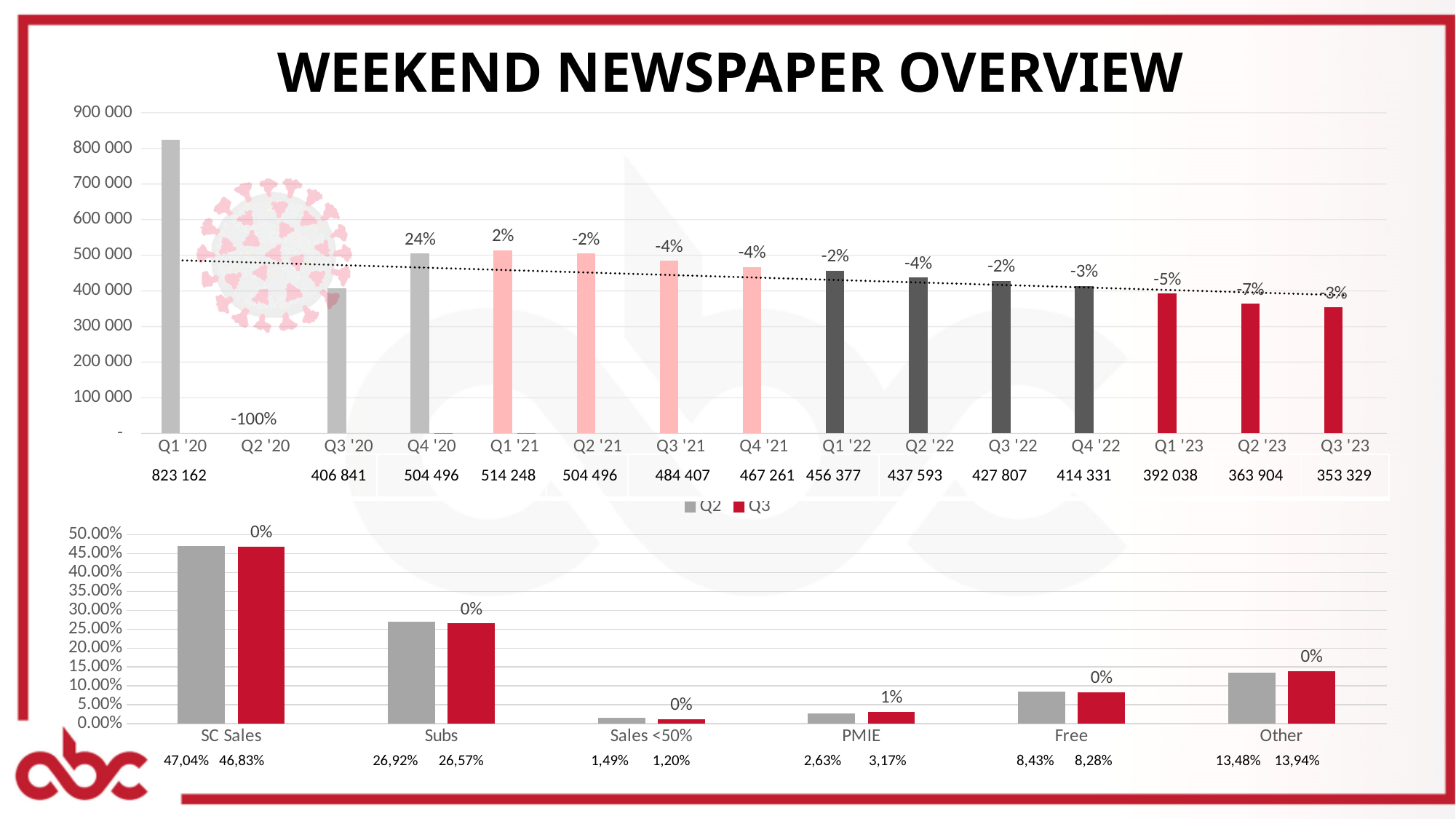
In the top chart, what percentage change label is shown above the Q4 '20 bar? 24% In the bottom chart, how many series does the legend list? 2 In the top chart, is the value for Q1 '20 greater or less than 800 000? greater In the top chart, which is larger: the value for Q4 '20 or the value for Q1 '21? Q1 '21 In the top chart, how many quarters are shown on the x axis? 15 What kind of chart is the bottom chart? bar chart In the top chart, what is the difference between the values for Q1 '23 and Q2 '23? 28 134 In the bottom chart, which category has the highest Q2 value? SC Sales In the top chart, which quarter has the highest value? Q1 '20 In the top chart, do the values rise or fall from Q1 '21 to Q3 '23? fall In the top chart (Weekend Newspaper Overview), what is the value for Q3 '23? 353 329 In the bottom chart, what is the Q3 value for PMIE? 3,17%